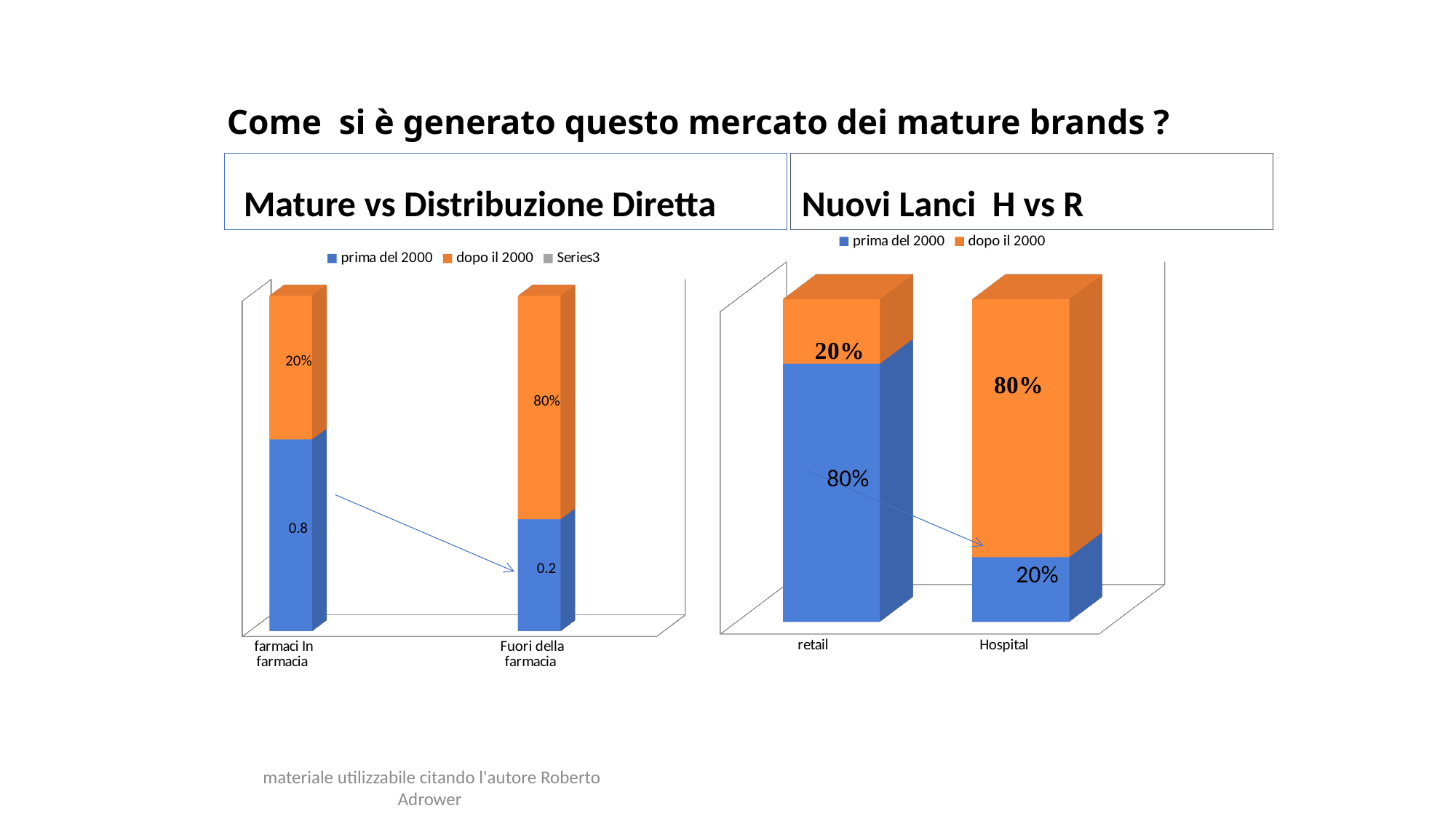
In the 'Nuovi Lanci H vs R' chart, which category has the higher 'prima del 2000' value, 'retail' or 'Hospital'? retail In the 'Mature vs Distribuzione Diretta' chart, how many series does the legend list? 3 What kind of chart is the 'Nuovi Lanci H vs R' chart? Stacked bar chart In the 'Mature vs Distribuzione Diretta' chart, what is the value of 'prima del 2000' for 'farmaci In farmacia'? 0.8 In the 'Nuovi Lanci H vs R' chart, how many categories are shown on the x axis? 2 In the 'Nuovi Lanci H vs R' chart, what is the value of 'prima del 2000' for 'Hospital'? 20% In the 'Nuovi Lanci H vs R' chart, what is the value of 'dopo il 2000' for 'Hospital'? 80% In the 'Mature vs Distribuzione Diretta' chart, what is the value of 'dopo il 2000' for 'farmaci In farmacia'? 20% In the 'Nuovi Lanci H vs R' chart, what is the difference between the 'dopo il 2000' values for 'Hospital' and 'retail'? 60% In the 'Mature vs Distribuzione Diretta' chart, what is the value of 'dopo il 2000' for 'Fuori della farmacia'? 80% In the 'Nuovi Lanci H vs R' chart, what is the value of 'prima del 2000' for 'retail'? 80% In the 'Mature vs Distribuzione Diretta' chart, what is the value of 'prima del 2000' for 'Fuori della farmacia'? 0.2